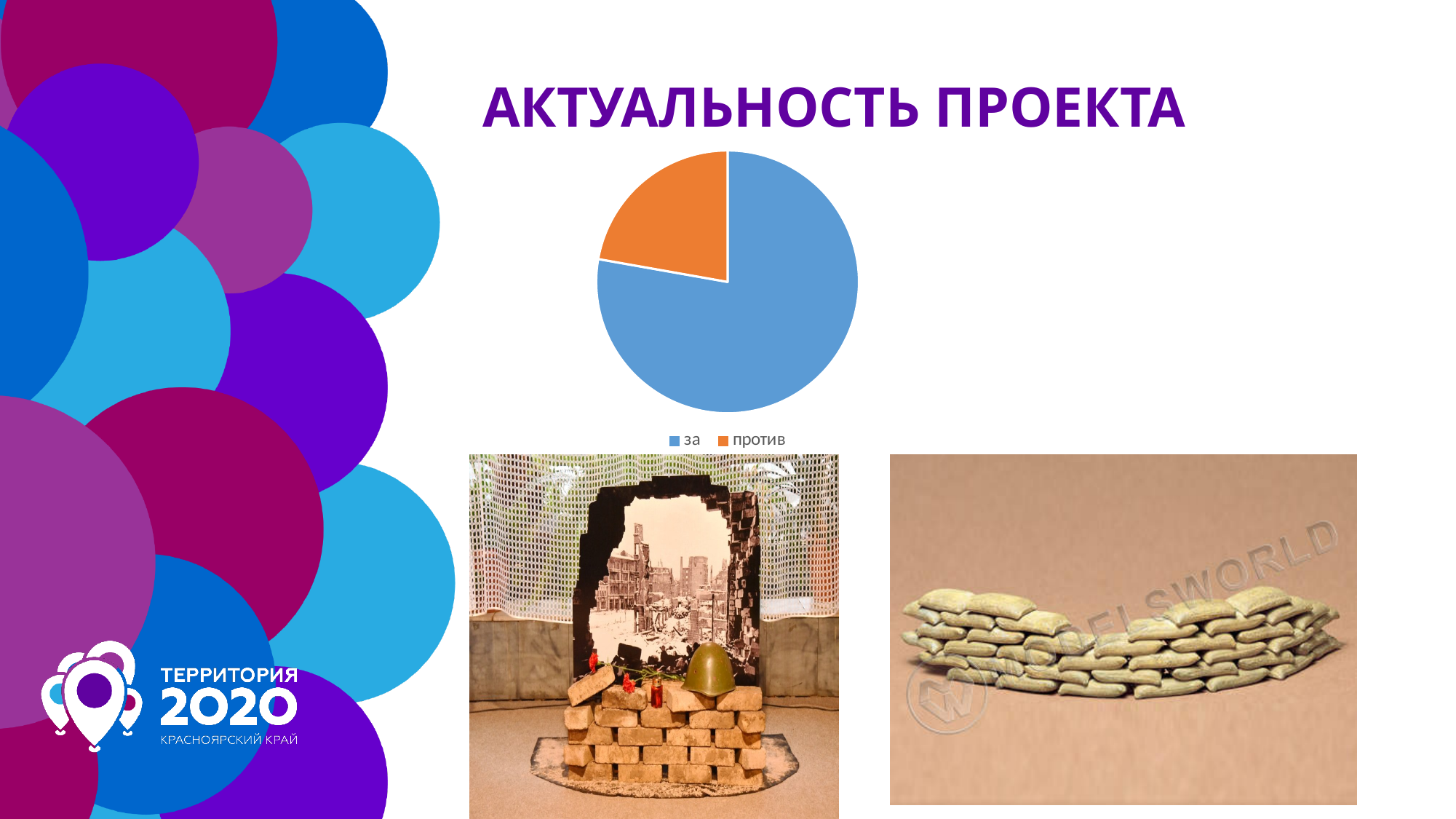
What kind of chart is shown on the slide? pie chart Which category has the smallest slice in the pie chart? против Which category has the largest slice in the pie chart? за What are the two legend entries of the pie chart? за, против What colour is the "за" slice in the pie chart? blue How many entries does the legend of the pie chart list? 2 How many slices does the pie chart have? 2 Which slice is larger in the pie chart, "за" or "против"? за